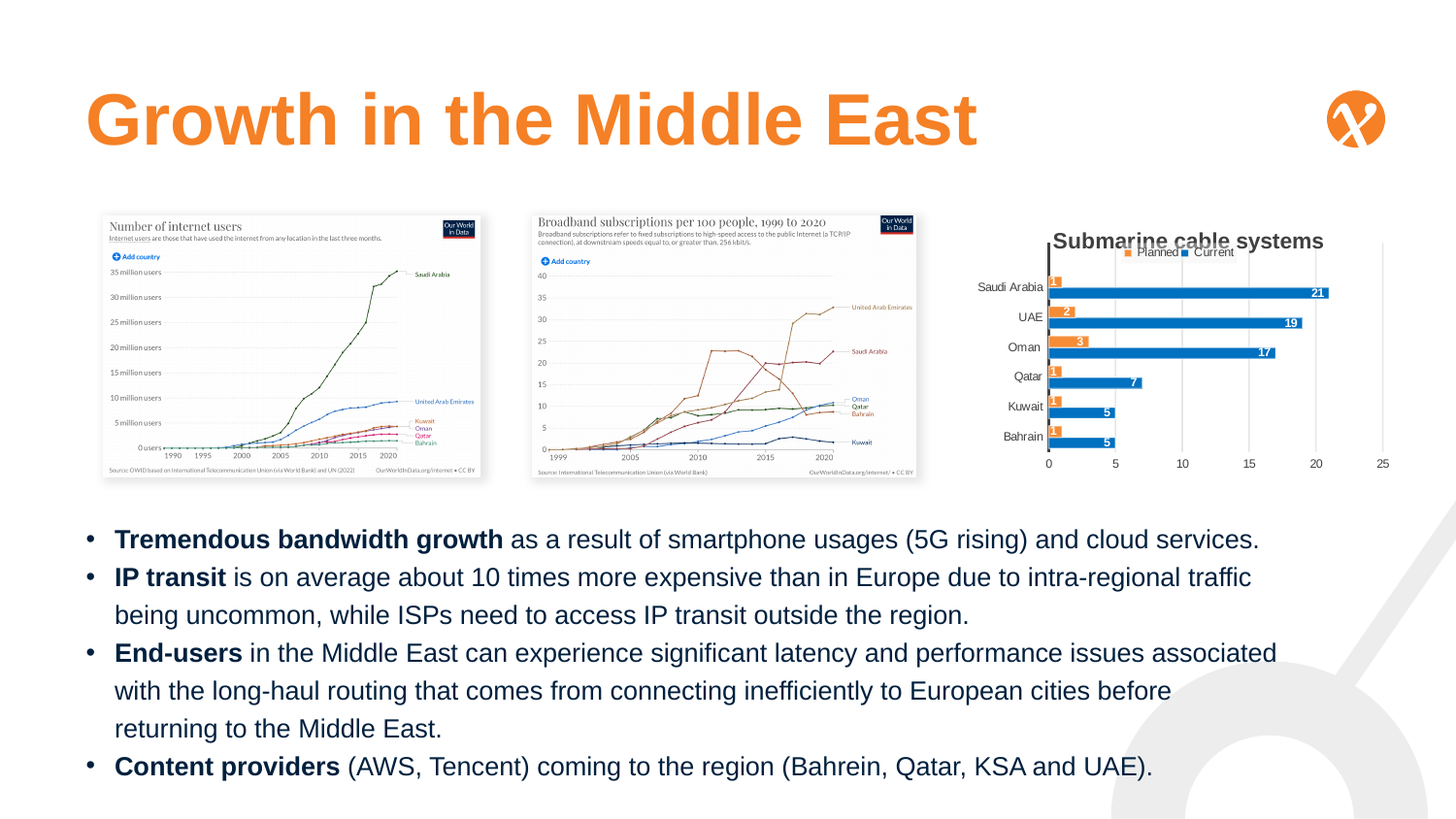
In the Number of internet users chart, do the values for Saudi Arabia rise or fall from 2000 to 2020? Rise In the Broadband subscriptions per 100 people chart, is the value for United Arab Emirates in 2020 greater or less than 30? greater In the Submarine cable systems chart, how many countries are shown? 6 How many series does the legend of the Submarine cable systems chart list? 2 In the Submarine cable systems chart, which is larger: the Current value for Oman or the Current value for UAE? UAE In the Submarine cable systems chart, what is the difference between the Current values for UAE and Qatar? 12 In the Submarine cable systems chart, what is the total of Planned and Current for Kuwait? 6 What kind of chart is the Submarine cable systems chart? Bar chart In the Submarine cable systems chart, what is the Current value for Saudi Arabia? 21 In the Number of internet users chart, which country has the highest number of internet users in 2020? Saudi Arabia In the Submarine cable systems chart, which country has the highest Current value? Saudi Arabia In the Submarine cable systems chart, what is the Planned value for Oman? 3